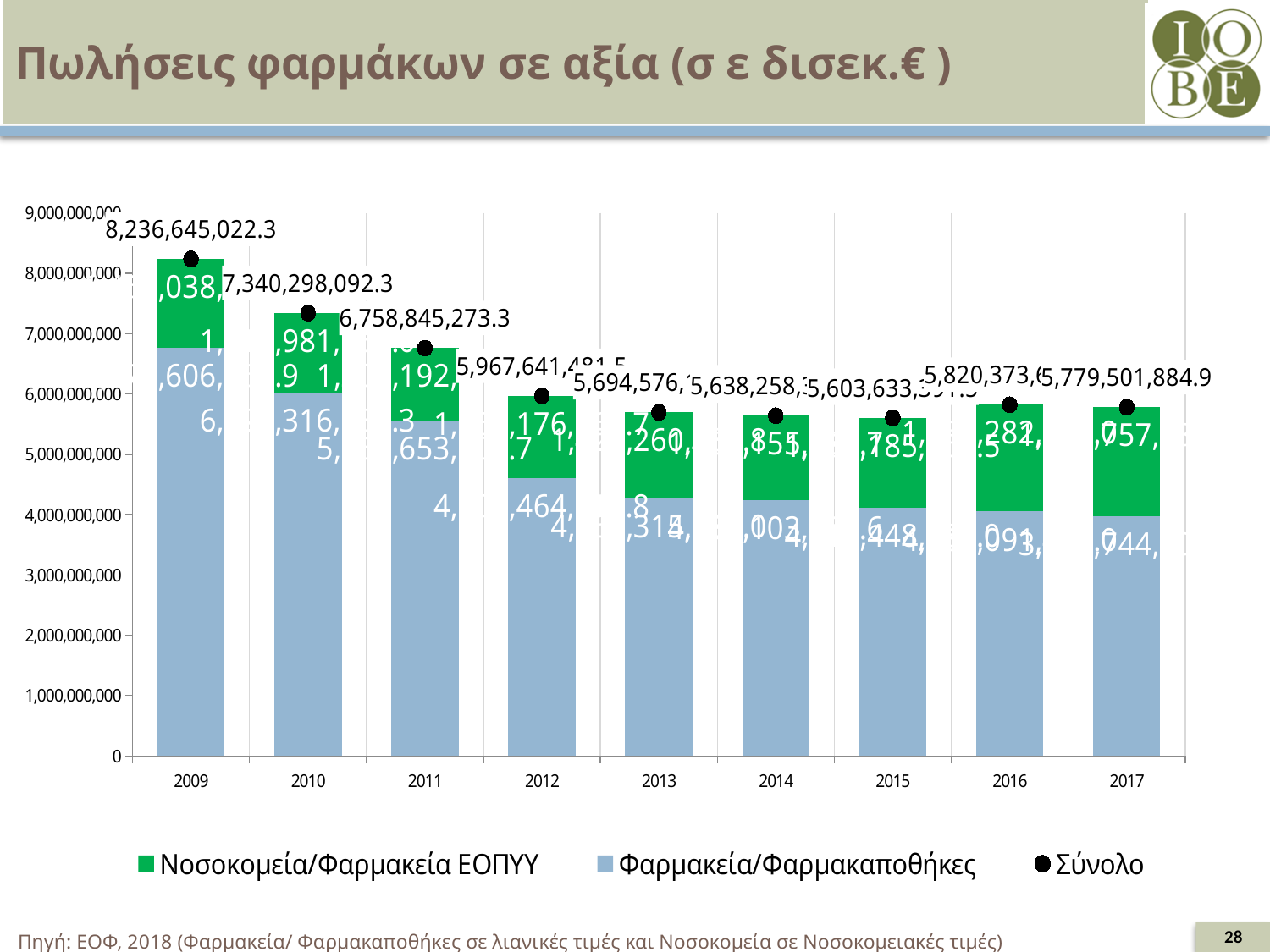
What is the total (Σύνολο) value for 2010? 7,340,298,092.3 Is the total value for 2017 greater or less than 6,000,000,000? less What is the total (Σύνολο) value for 2011? 6,758,845,273.3 How many series does the legend list? 3 Which year has the larger total value, 2009 or 2017? 2009 Do the total values rise or fall from 2009 to 2015? fall How many years are shown on the x axis? 9 What is the total (Σύνολο) value for 2009? 8,236,645,022.3 What is the total (Σύνολο) value for 2017? 5,779,501,884.9 Is the total value for 2009 greater or less than 8,000,000,000? greater Which year has the highest total (Σύνολο) value? 2009 What is the difference between the total values for 2009 and 2010? 896,346,930.0